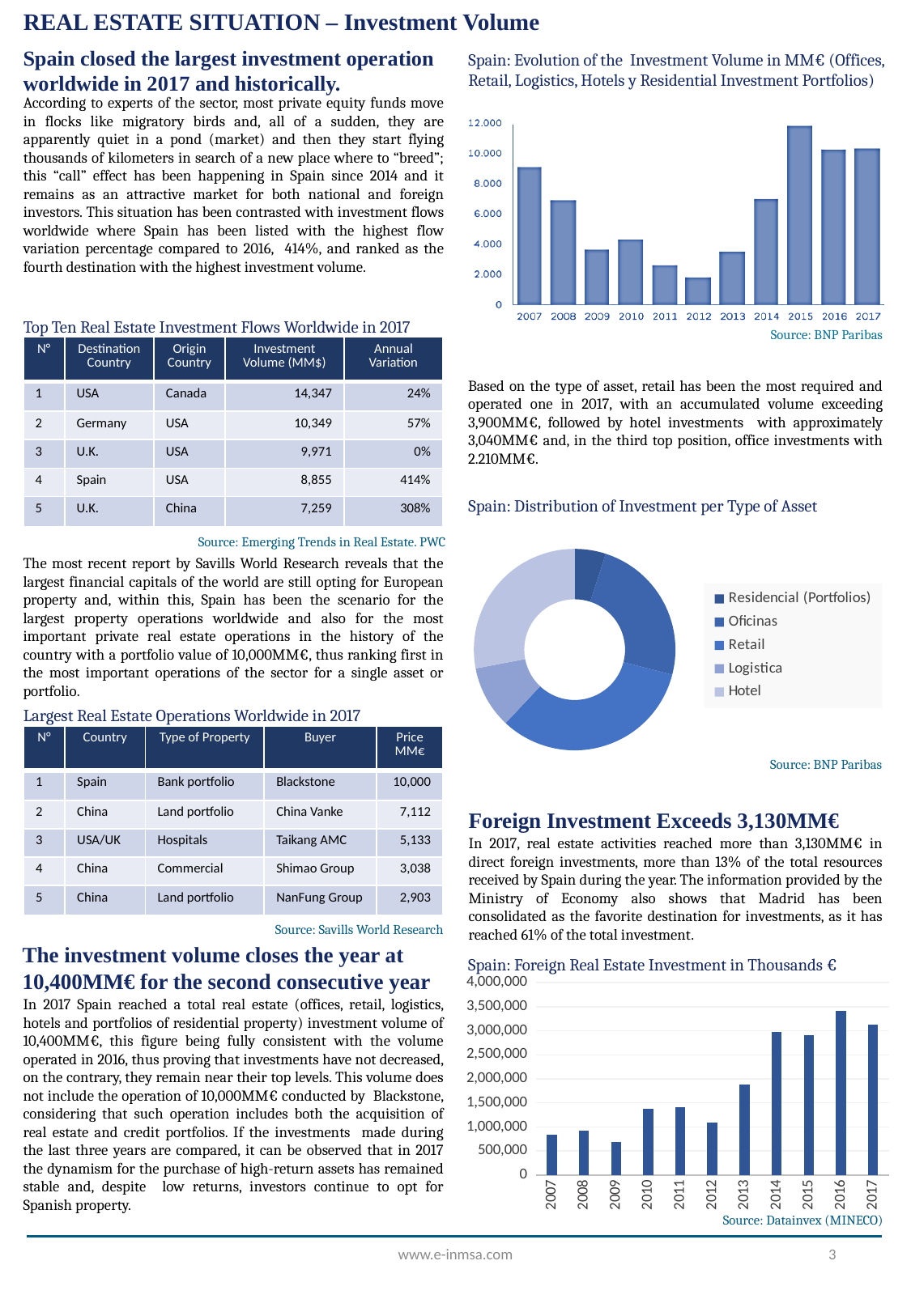
In the chart 'Spain: Distribution of Investment per Type of Asset', which asset type has the smallest slice? Residencial (Portfolios) In the chart 'Spain: Foreign Real Estate Investment in Thousands €', which year has the lowest value? 2009 In the chart 'Spain: Evolution of the Investment Volume in MM€', is the value for 2007 greater or less than 8.000? greater In the chart 'Spain: Evolution of the Investment Volume in MM€', is the value for 2009 greater or less than 4.000? less What kind of chart is 'Spain: Distribution of Investment per Type of Asset'? Doughnut (pie) chart In the chart 'Spain: Evolution of the Investment Volume in MM€', how many years are shown on the x axis? 11 In the chart 'Spain: Evolution of the Investment Volume in MM€', which is larger, the value for 2015 or the value for 2017? 2015 In the chart 'Spain: Evolution of the Investment Volume in MM€', which year has the highest investment volume? 2015 In the chart 'Spain: Foreign Real Estate Investment in Thousands €', which year has the highest value? 2016 In the chart 'Spain: Distribution of Investment per Type of Asset', how many asset types does the legend list? 5 In the chart 'Spain: Evolution of the Investment Volume in MM€', which year has the lowest investment volume? 2012 In the chart 'Spain: Foreign Real Estate Investment in Thousands €', is the value for 2013 greater or less than 2,000,000? less